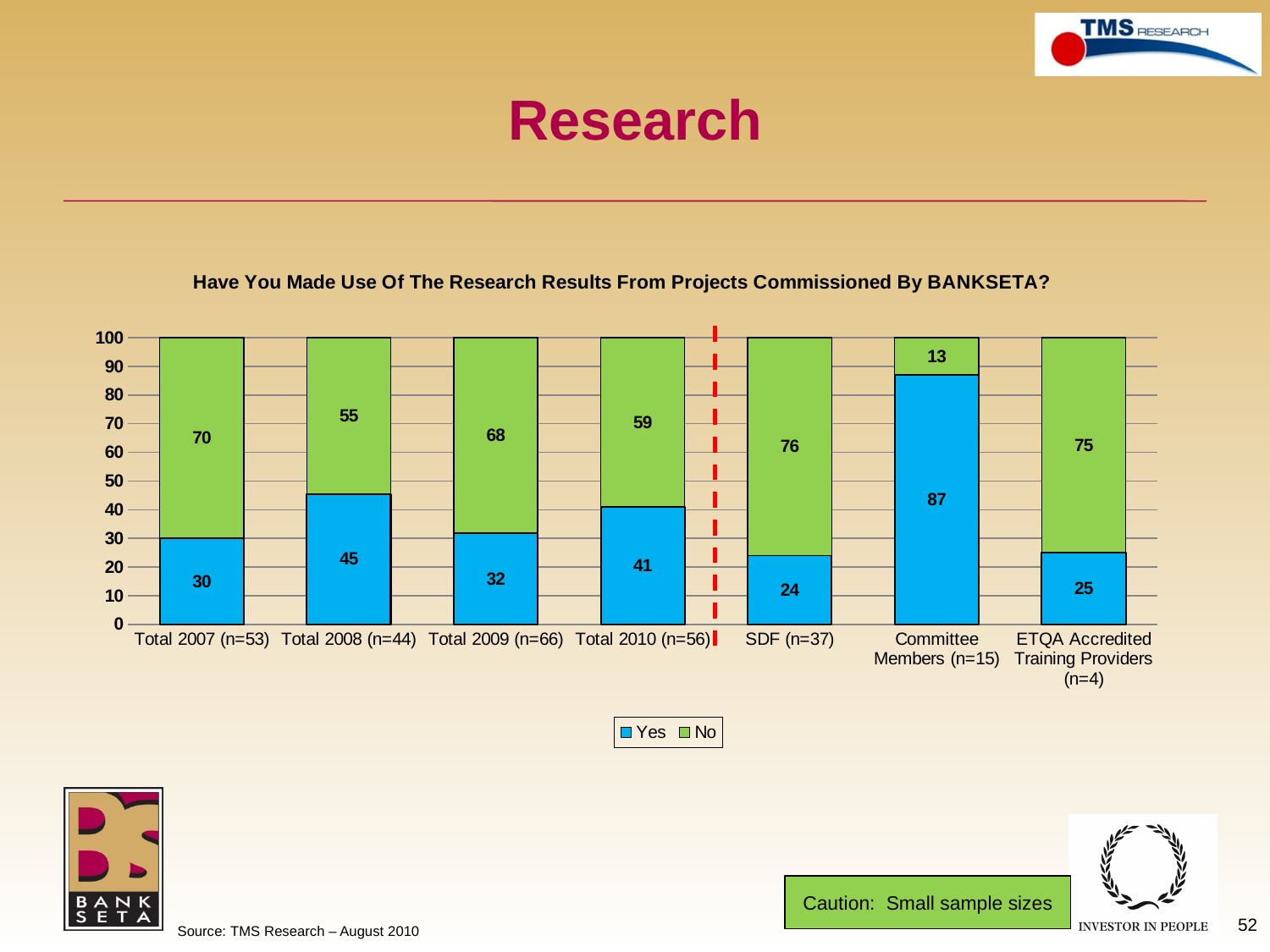
What is the difference between the 'Yes' values for Total 2010 (n=56) and Total 2009 (n=66)? 9 How many series does the legend list? 2 What is the title of the chart? Have You Made Use Of The Research Results From Projects Commissioned By BANKSETA? Which is larger: the 'No' value for Total 2007 (n=53) or the 'No' value for ETQA Accredited Training Providers (n=4)? ETQA Accredited Training Providers (n=4) What kind of chart is shown? Stacked bar chart How many categories are shown on the x axis? 7 What is the 'No' value for SDF (n=37)? 76 What is the 'Yes' value for Committee Members (n=15)? 87 What is the total of the stacked bar for Total 2009 (n=66)? 100 Which category has the lowest 'Yes' value? SDF (n=37) Which category has the highest 'Yes' value? Committee Members (n=15) What is the 'Yes' value for Total 2008 (n=44)? 45